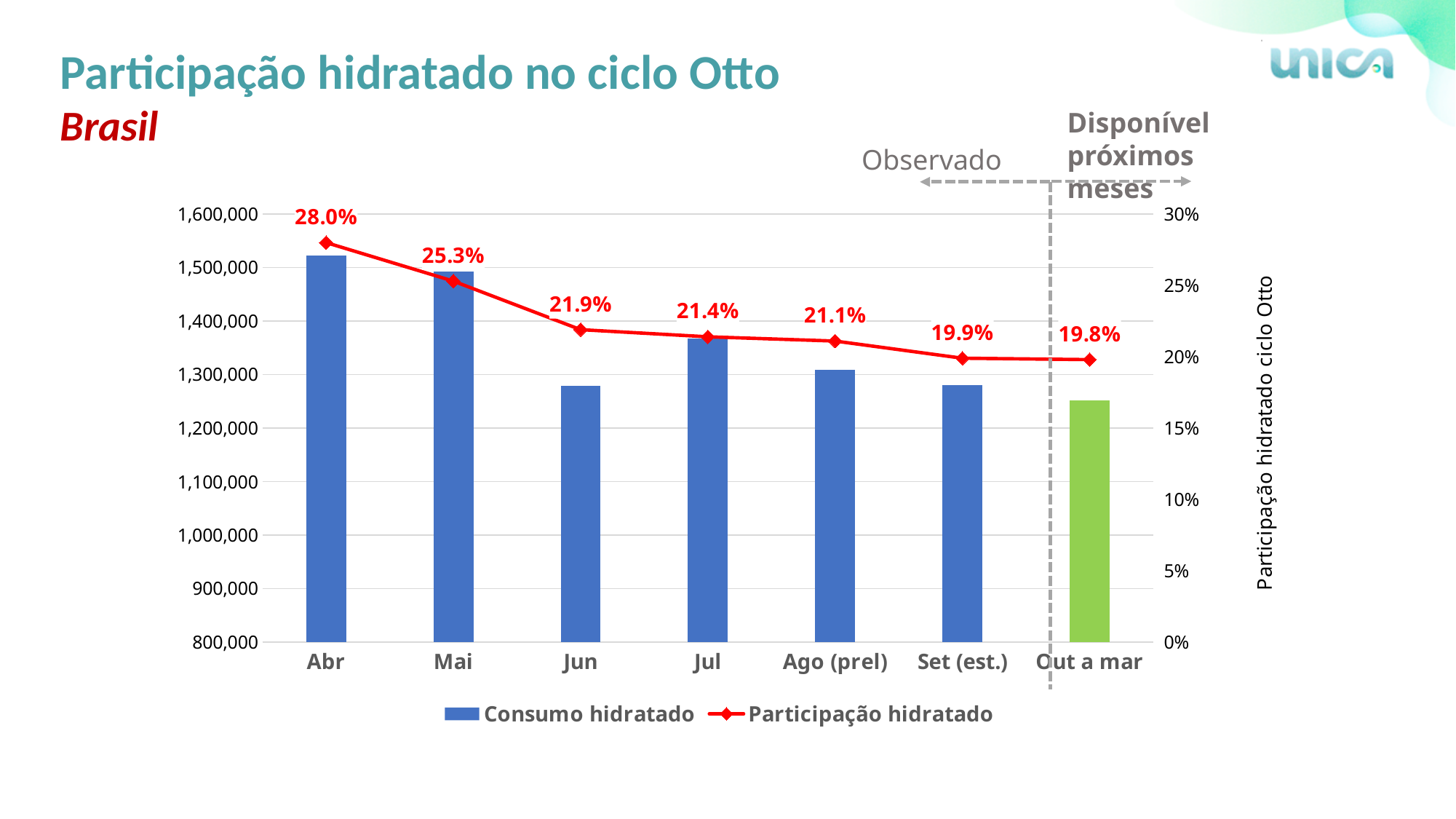
Which month has the highest Participação hidratado? Abr Which category has the lowest Participação hidratado? Out a mar Which has a larger Consumo hidratado bar, Abr or Jun? Abr Is the Consumo hidratado value for Abr greater or less than 1,500,000? greater Does the Participação hidratado line rise or fall from Abr to Out a mar? fall How many series does the legend list? 2 Is the Consumo hidratado value for Jun greater or less than 1,300,000? less What is the Participação hidratado value for Abr? 28.0% What is the Participação hidratado value for Ago (prel)? 21.1% How many categories are shown on the x axis? 7 What is the Participação hidratado value for Out a mar? 19.8% What is the difference between the Participação hidratado for Abr and Mai? 2.7%